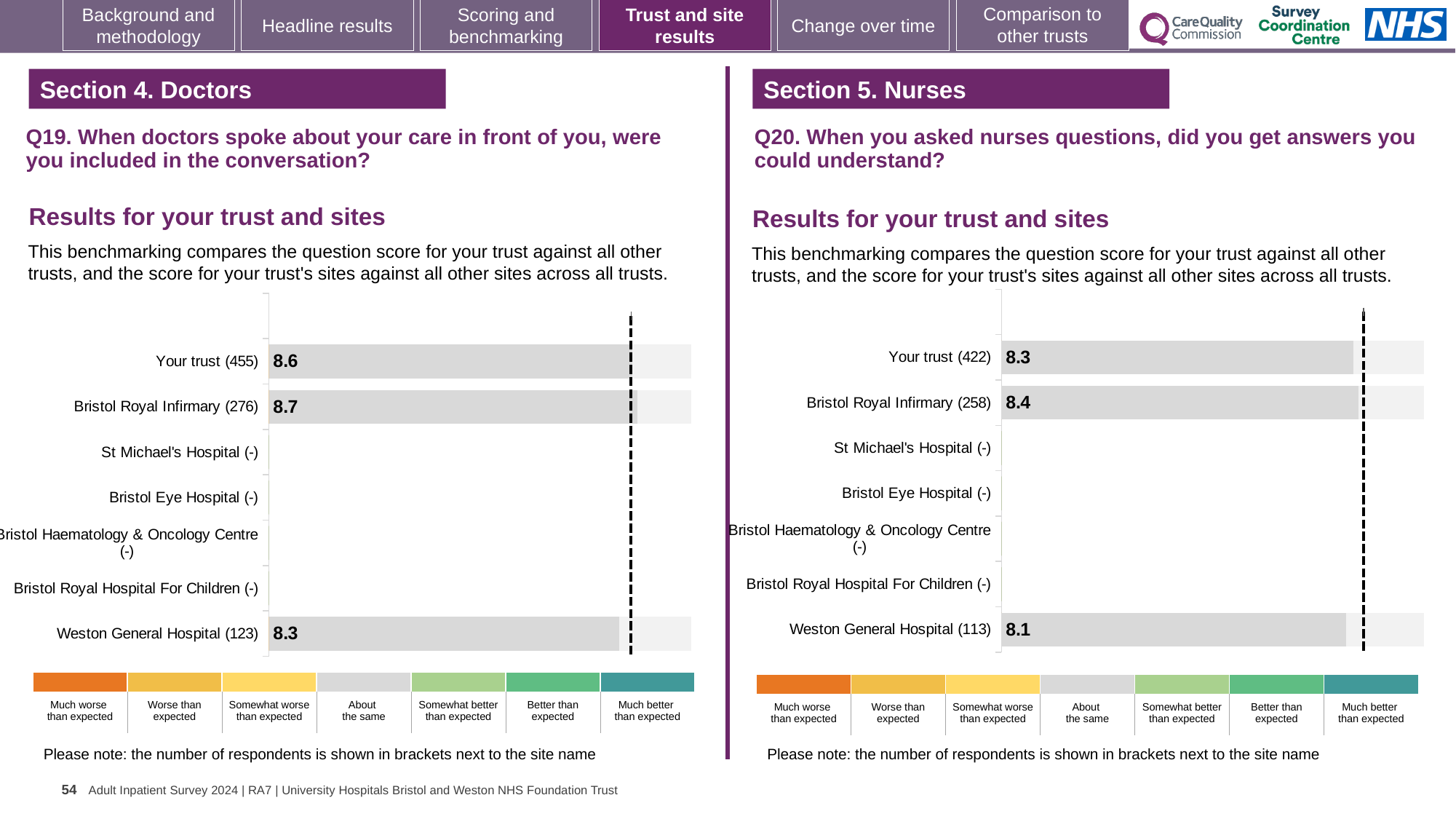
In the Q19 chart on the left, what is the score for Weston General Hospital? 8.3 In the Q19 chart on the left, what is the difference between the Bristol Royal Infirmary score and the Weston General Hospital score? 0.4 How many site or trust rows are listed on the vertical axis of the Q19 chart on the left? 7 In the Q20 chart on the right, which site or trust row has the lowest score? Weston General Hospital In the Q20 chart on the right, what is the score for Weston General Hospital? 8.1 In the Q19 chart on the left, what is the score for Your trust? 8.6 What kind of chart is the Q20 chart on the right? Bar chart In the Q19 chart on the left, which site or trust row has the highest score? Bristol Royal Infirmary In the Q20 chart on the right, what is the score for Your trust? 8.3 In the Q19 chart on the left, what is the score for Bristol Royal Infirmary? 8.7 In the Q20 chart on the right, what is the difference between the Your trust score and the Weston General Hospital score? 0.2 In the Q20 chart on the right, which has the higher score, Bristol Royal Infirmary or Your trust? Bristol Royal Infirmary